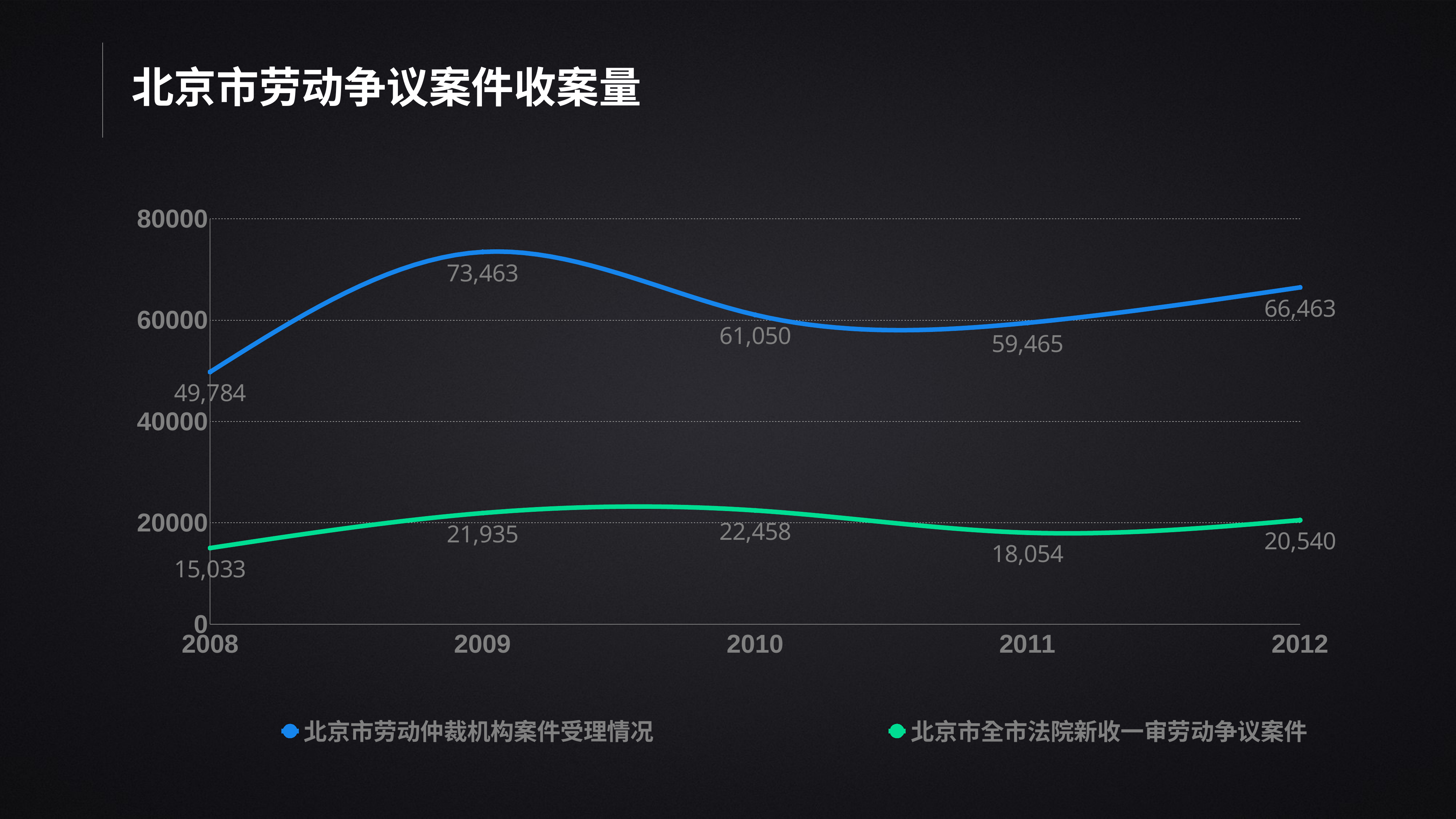
What is the value for 北京市劳动仲裁机构案件受理情况 in 2012? 66,463 In which year is 北京市劳动仲裁机构案件受理情况 highest? 2009 What is the difference between the 2010 and 2011 values for 北京市全市法院新收一审劳动争议案件? 4,404 Is the value for 北京市劳动仲裁机构案件受理情况 in 2008 greater or less than 60000? less How many series does the legend list? 2 How many years are shown on the x axis? 5 Which is larger for 北京市全市法院新收一审劳动争议案件: the 2009 value or the 2010 value? 2010 In which year is 北京市全市法院新收一审劳动争议案件 lowest? 2008 What is the value for 北京市全市法院新收一审劳动争议案件 in 2011? 18,054 What kind of chart is shown on the slide? line chart What is the difference between the 2009 and 2008 values for 北京市劳动仲裁机构案件受理情况? 23,679 What is the value for 北京市劳动仲裁机构案件受理情况 in 2009? 73,463